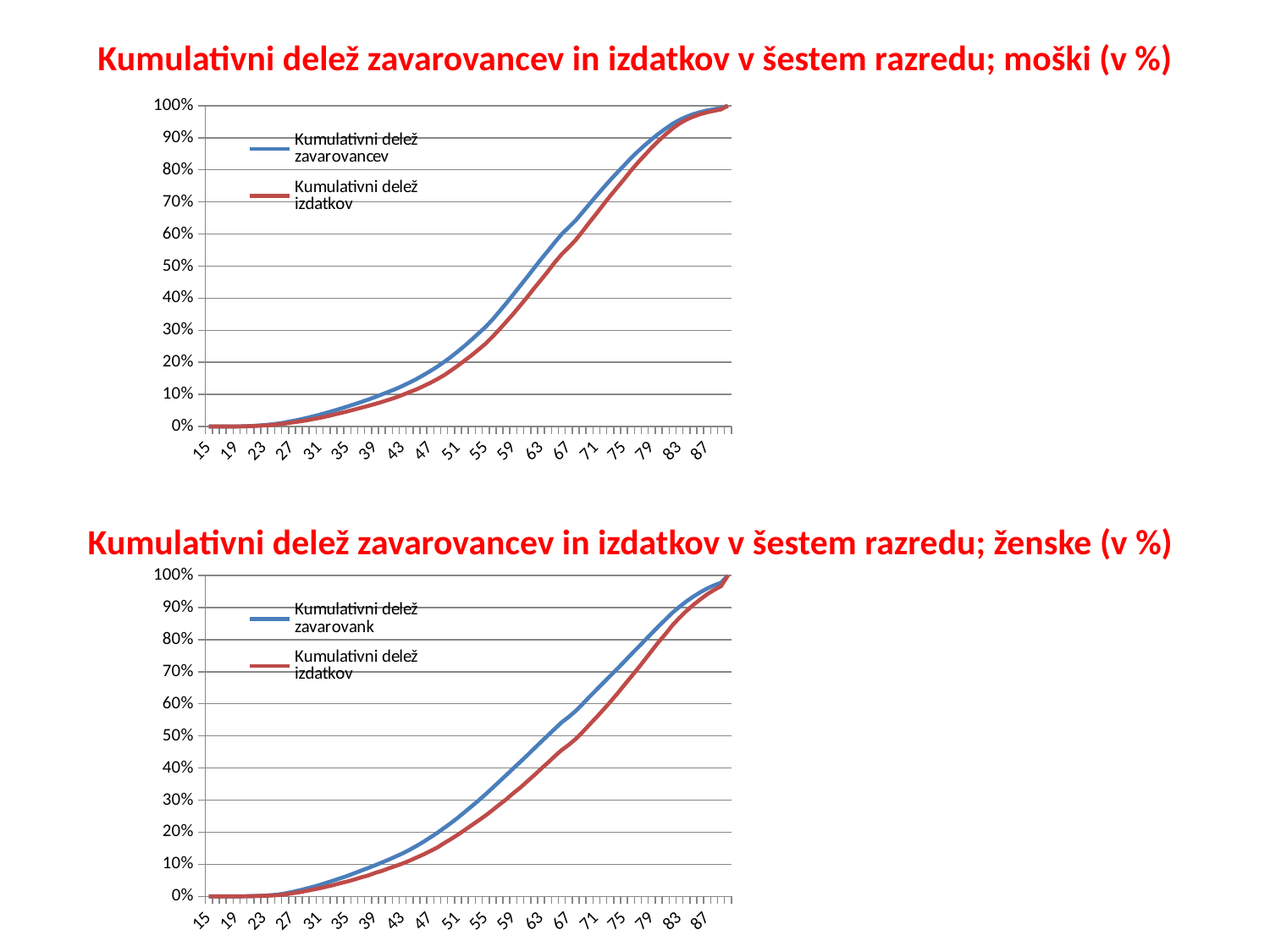
How many series does the legend of the bottom chart (ženske) list? 2 What is the title of the bottom chart? Kumulativni delež zavarovancev in izdatkov v šestem razredu; ženske (v %) In the top chart (moški), do the values rise or fall as age increases along the x axis? rise In the bottom chart (ženske), is the value of Kumulativni delež izdatkov at age 63 greater or less than 50%? less In the bottom chart (ženske), which series has the higher value at age 71? Kumulativni delež zavarovank What kind of chart is the top chart (moški)? line chart In the top chart (moški), is the value of Kumulativni delež izdatkov at age 55 greater or less than 30%? less In the top chart (moški), what colour is the line for Kumulativni delež izdatkov? red In the top chart (moški), which series has the higher value at age 63? Kumulativni delež zavarovancev